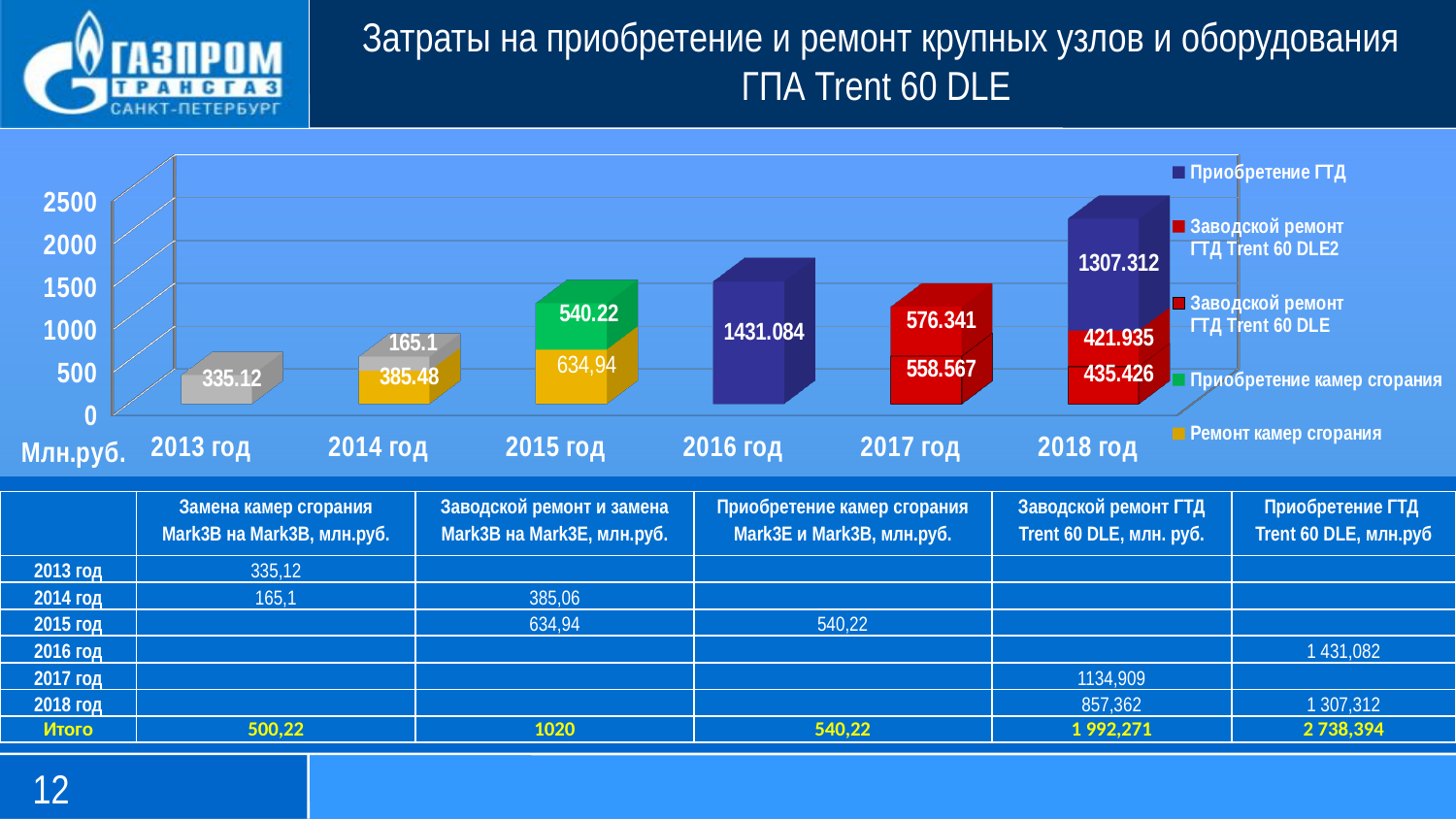
What is the total of the stacked bar for 2018 год? 2164.673 Which year has the tallest stacked bar? 2018 год Which year has the shortest stacked bar? 2013 год What value is labelled on the green segment for 2015 год? 540.22 What kind of chart is shown on the slide? stacked bar chart What is the difference between the blue segment for 2016 год (1431.084) and the blue segment for 2018 год (1307.312)? 123.772 What value is labelled on the blue segment for 2016 год? 1431.084 What value is labelled on the bar for 2013 год? 335.12 How many series does the chart legend list? 5 What value is labelled on the top blue segment for 2018 год? 1307.312 Is the value for 2013 год greater or less than 500? less How many years are shown on the x axis of the chart? 6